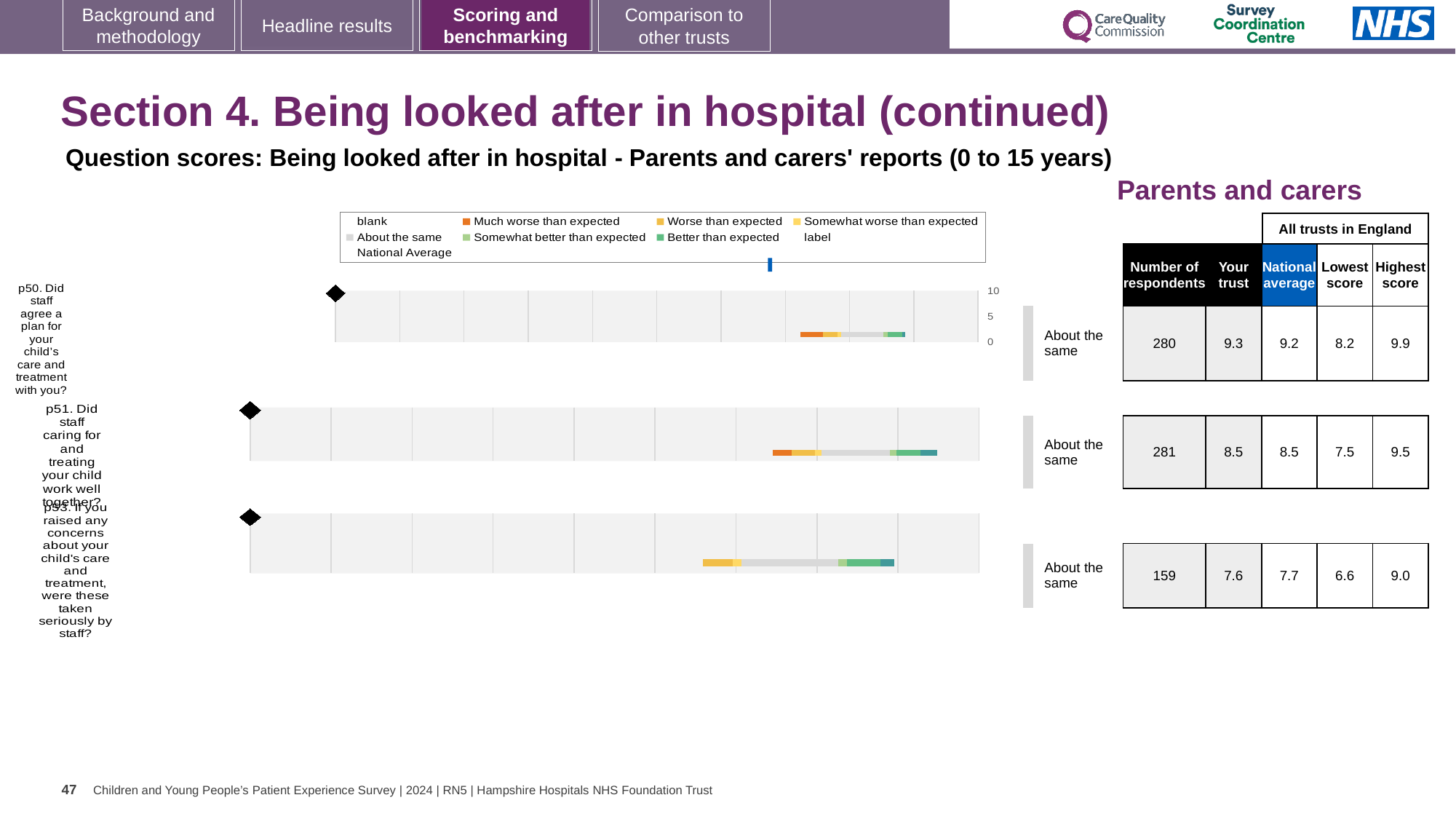
Is the 'Your trust' score for p53 higher or lower than the national average for p53? lower How many survey questions are plotted on this slide? 3 What type of chart is used to show the question scores? bar chart How many entries does the chart legend list? 9 What is the highest score across all trusts in England for p53? 9.0 Which of the three questions shown has the highest 'Your trust' score? p50 What is the 'Your trust' score for p50 (Did staff agree a plan for your child's care and treatment with you?)? 9.3 How many respondents answered p53 (If you raised any concerns about your child's care and treatment, were these taken seriously by staff?)? 159 What is the national average score for p51 (Did staff caring for and treating your child work well together?)? 8.5 What is the difference between the highest score and the lowest score for p50? 1.7 What benchmark category is shown for each of the three questions? About the same Which of the three questions shown has the lowest 'Your trust' score? p53